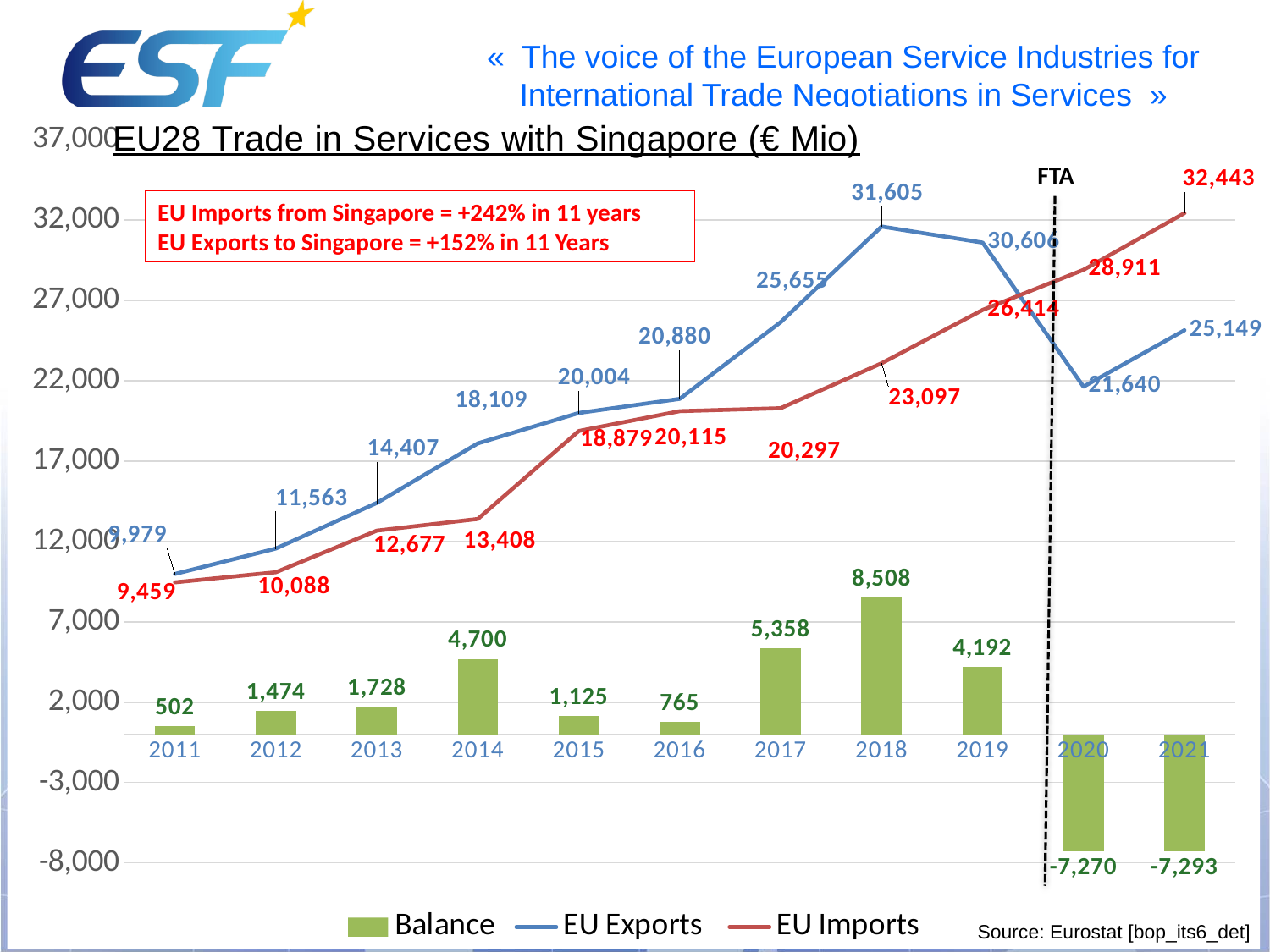
By how much did EU Exports increase from 2020 to 2021? 3,509 In 2020, which is larger: EU Exports or EU Imports? EU Imports In which year is the EU Imports value lowest? 2011 How many years are shown on the x axis? 11 What is the value of EU Imports in 2021? 32,443 What is the Balance value for 2014? 4,700 What is the value of EU Exports in 2018? 31,605 Do EU Imports rise or fall from 2011 to 2021? Rise How many series does the legend list? 3 In which year is the Balance highest? 2018 What kind of chart is this? Combined bar and line chart What is the difference between EU Exports and EU Imports in 2018? 8,508